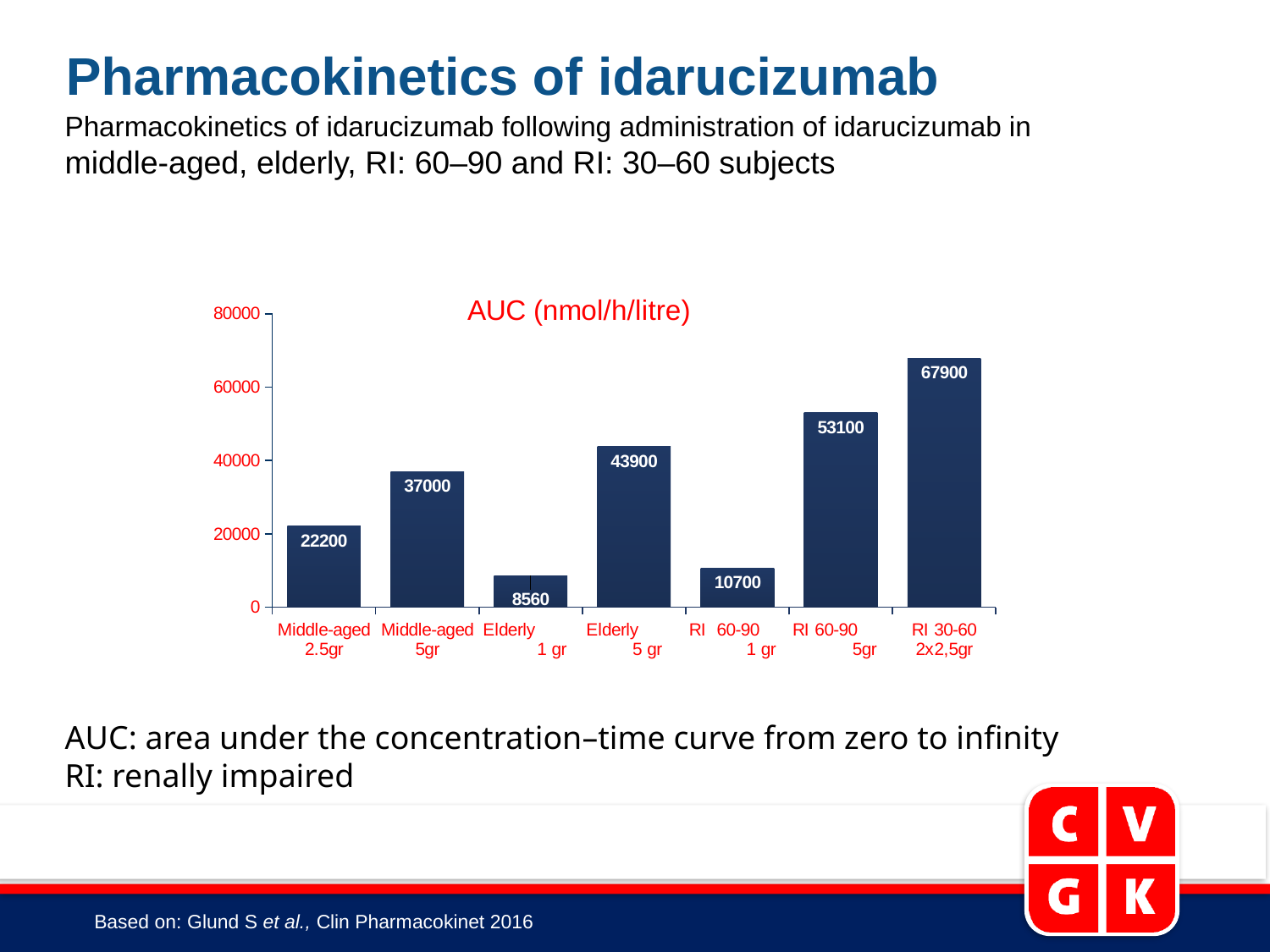
Is the AUC value for RI 60-90 1 gr greater or less than 20000? less Which category has the lowest AUC value? Elderly 1 gr Which has a larger AUC value, Elderly 5 gr or Middle-aged 5gr? Elderly 5 gr How many categories are shown in the chart? 7 What kind of chart is shown on the slide? bar chart What is the AUC value for RI 60-90 5gr? 53100 What is the AUC value for Elderly 1 gr? 8560 Which category has the highest AUC value? RI 30-60 2x2,5gr What is the difference in AUC between Middle-aged 5gr and Middle-aged 2.5gr? 14800 What is the difference in AUC between RI 30-60 2x2,5gr and RI 60-90 5gr? 14800 What is the AUC value for Middle-aged 2.5gr? 22200 What is the title of the chart? AUC (nmol/h/litre)